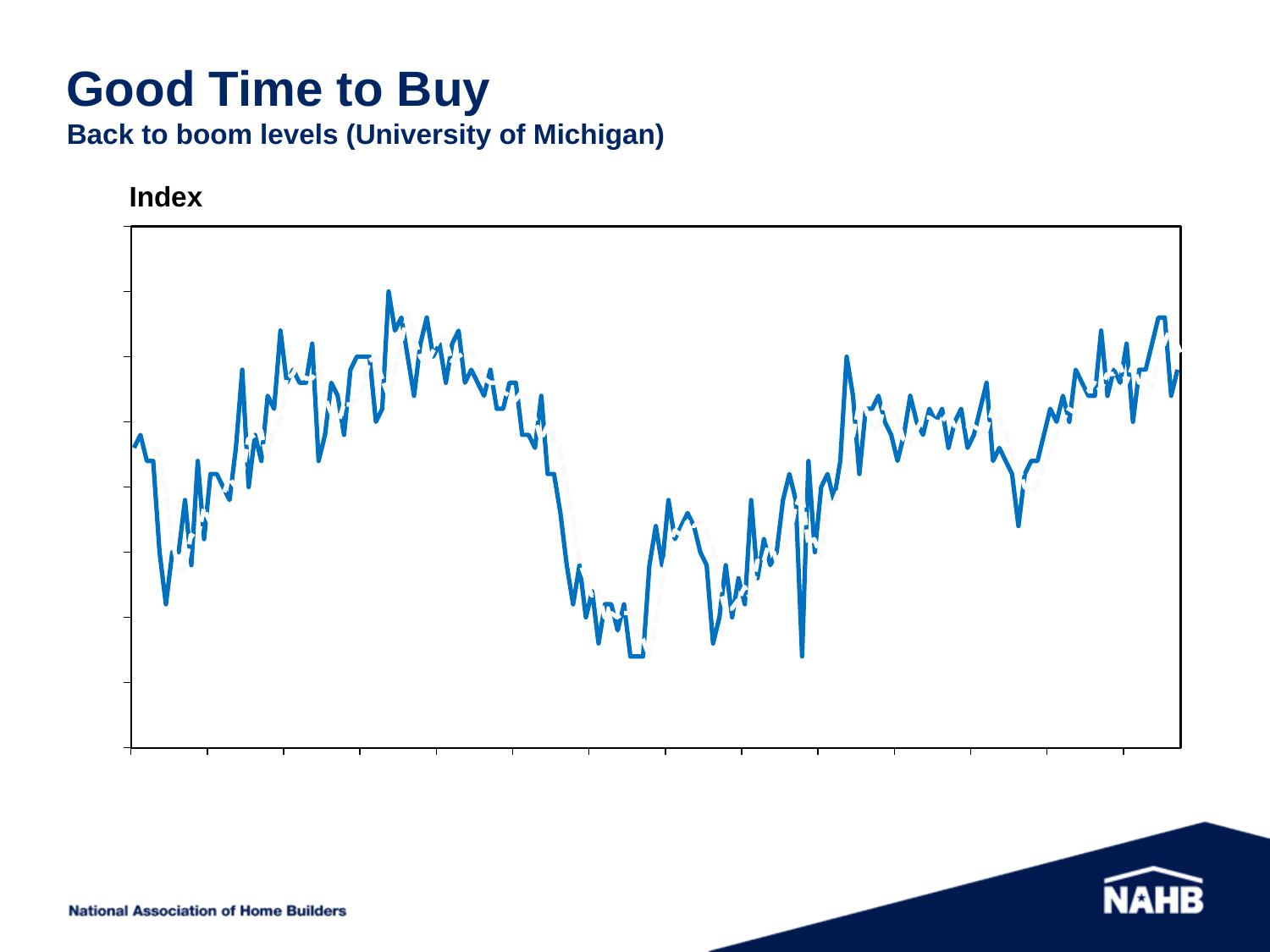
Does the line end higher or lower than where it starts at the left of the chart? higher What is the title of the slide's chart? Good Time to Buy What label is shown above the vertical axis of the chart? Index What kind of chart is shown on the slide? line chart